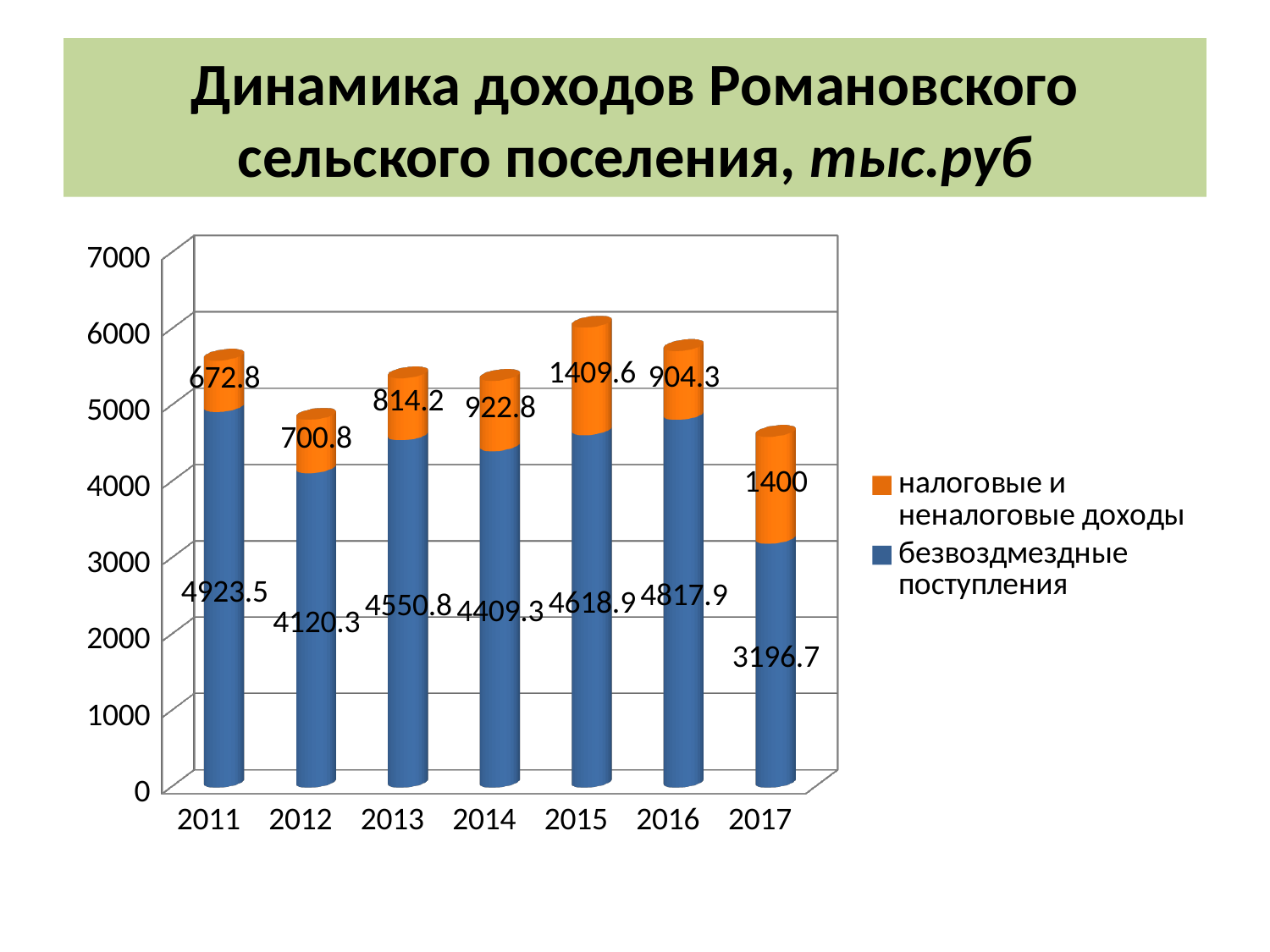
What is the total of the stacked bar for 2017? 4596.7 What is the difference between безвозмездные поступления in 2016 and in 2015? 199 How many years are shown on the x axis? 7 What is the value of безвозмездные поступления in 2011? 4923.5 Is the total of the stacked bar for 2017 greater or less than 5000? less Which is larger: безвозмездные поступления in 2011 or in 2012? 2011 What is the value of налоговые и неналоговые доходы in 2015? 1409.6 In which year is безвозмездные поступления the highest? 2011 In which year is безвозмездные поступления the lowest? 2017 How many series does the legend list? 2 What type of chart is shown on the slide? stacked bar chart What is the value of безвозмездные поступления in 2017? 3196.7